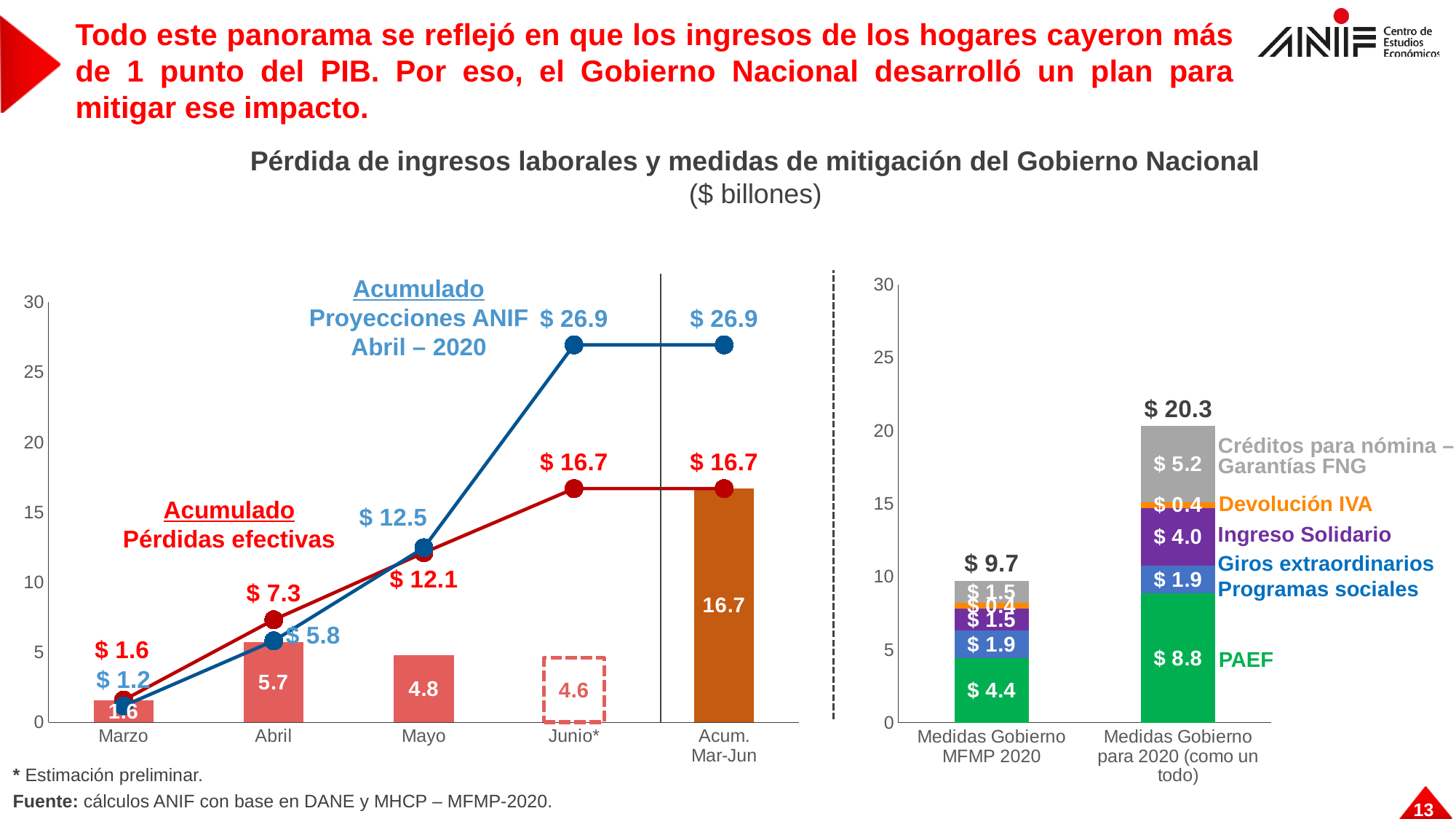
In the left chart, at Abril, which is larger: the Acumulado Pérdidas efectivas value or the Acumulado Proyecciones ANIF value? Acumulado Pérdidas efectivas What kind of chart is the right chart? Stacked bar chart In the left chart, is the Acum. Mar-Jun bar greater or less than 15? greater In the left chart, what is the monthly loss value shown for Abril? 5.7 In the left chart, what is the value of the Acumulado Pérdidas efectivas line at Mayo? $ 12.1 In the left chart, which month has the highest monthly loss bar among Marzo, Abril, Mayo and Junio*? Abril In the left chart, what is the difference between the ANIF projection and the effective losses at Junio*? 10.2 In the right chart, what is the PAEF value for Medidas Gobierno MFMP 2020? $ 4.4 In the left chart, what is the value of the Acumulado Proyecciones ANIF Abril – 2020 line at Junio*? $ 26.9 In the right chart, how many bars are plotted? 2 In the right chart, what is the difference between the two bar totals? 10.6 In the right chart, what is the total of the Medidas Gobierno para 2020 (como un todo) bar? $ 20.3